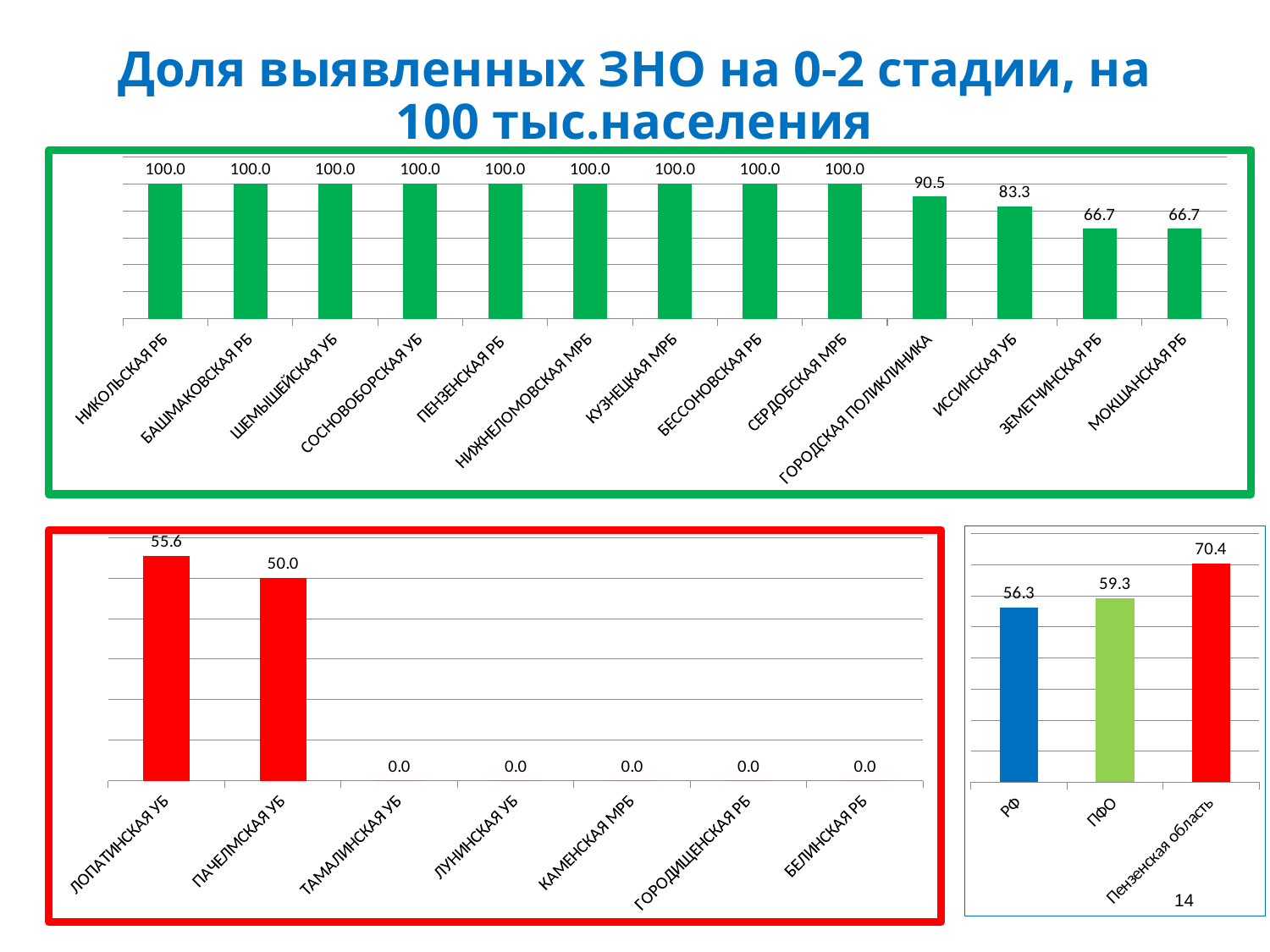
In the top chart, what is the value for Иссинская УБ? 83.3 In the bottom-left chart, how many categories are shown? 7 In the bottom-left chart, which is larger, the value for Лопатинская УБ or Пачелмская УБ? Лопатинская УБ What type of chart is the top chart? Bar chart In the bottom-left chart, what is the value for Лопатинская УБ? 55.6 In the bottom-right chart, what is the difference between the values for Пензенская область and ПФО? 11.1 In the top chart, what is the difference between the values for Иссинская УБ and Мокшанская РБ? 16.6 In the bottom-right chart, what is the value for Пензенская область? 70.4 In the bottom-right chart, what is the value for РФ? 56.3 In the top chart, how many categories are shown? 13 In the bottom-right chart, which category has the highest value? Пензенская область In the top chart, what is the value for Городская поликлиника? 90.5